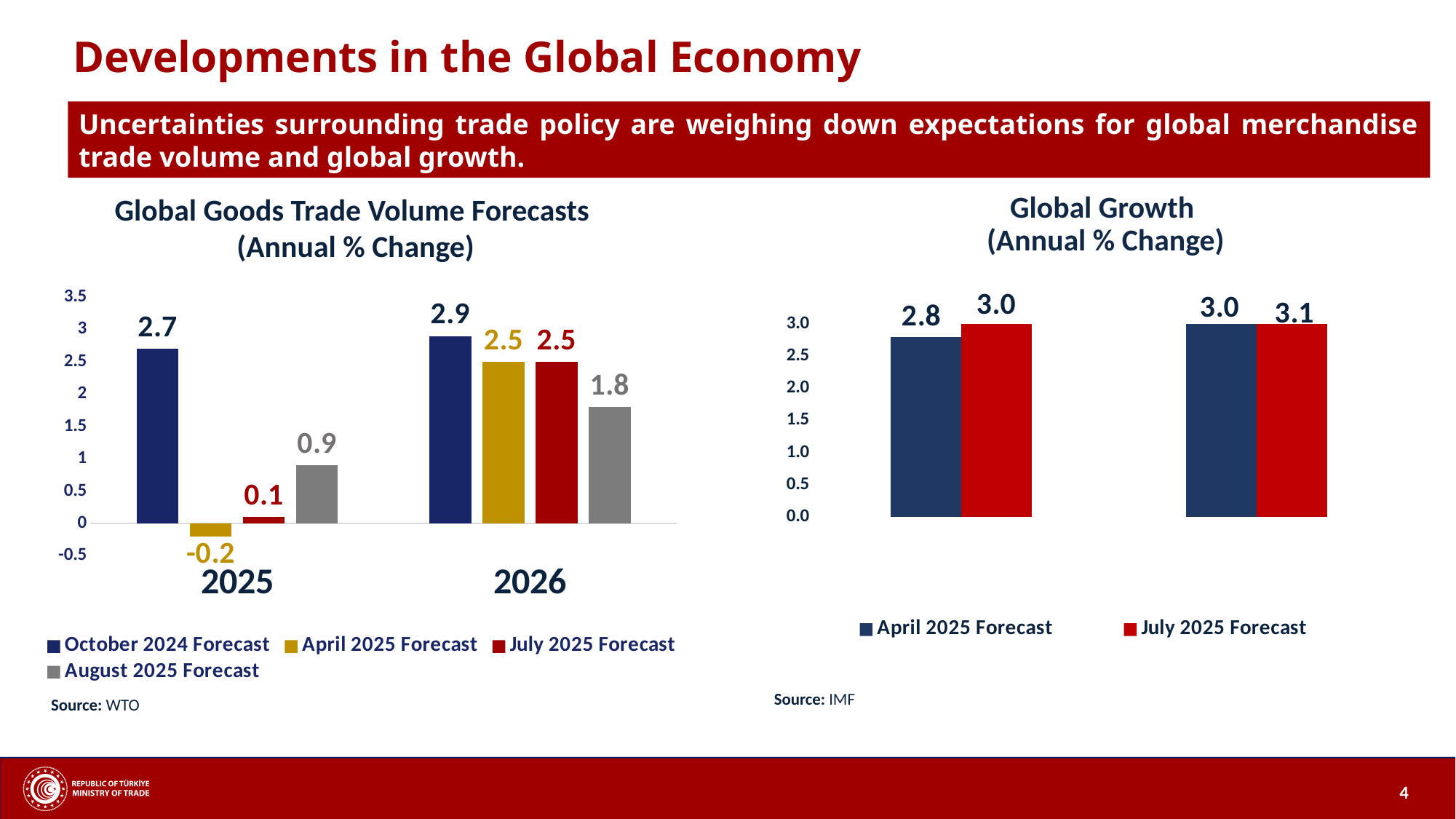
In the Global Goods Trade Volume Forecasts chart, which forecast series has the highest value for 2026? October 2024 Forecast In the Global Growth chart, what is the April 2025 Forecast value for the right group of bars? 3.0 In the Global Goods Trade Volume Forecasts chart, what is the April 2025 Forecast value for 2025? -0.2 What kind of chart is the Global Goods Trade Volume Forecasts chart? Bar chart In the Global Growth chart, what is the difference between the July 2025 Forecast and the April 2025 Forecast in the left group of bars? 0.2 In the Global Goods Trade Volume Forecasts chart, what is the difference between the October 2024 Forecast and the August 2025 Forecast for 2026? 1.1 In the Global Goods Trade Volume Forecasts chart, which forecast series has the lowest value for 2025? April 2025 Forecast In the Global Goods Trade Volume Forecasts chart, what is the August 2025 Forecast value for 2026? 1.8 In the Global Growth chart, how many series does the legend list? 2 In the Global Goods Trade Volume Forecasts chart, how many forecast series does the legend list? 4 In the Global Goods Trade Volume Forecasts chart, what is the October 2024 Forecast value for 2025? 2.7 In the Global Growth chart, what is the July 2025 Forecast value for the left group of bars? 3.0